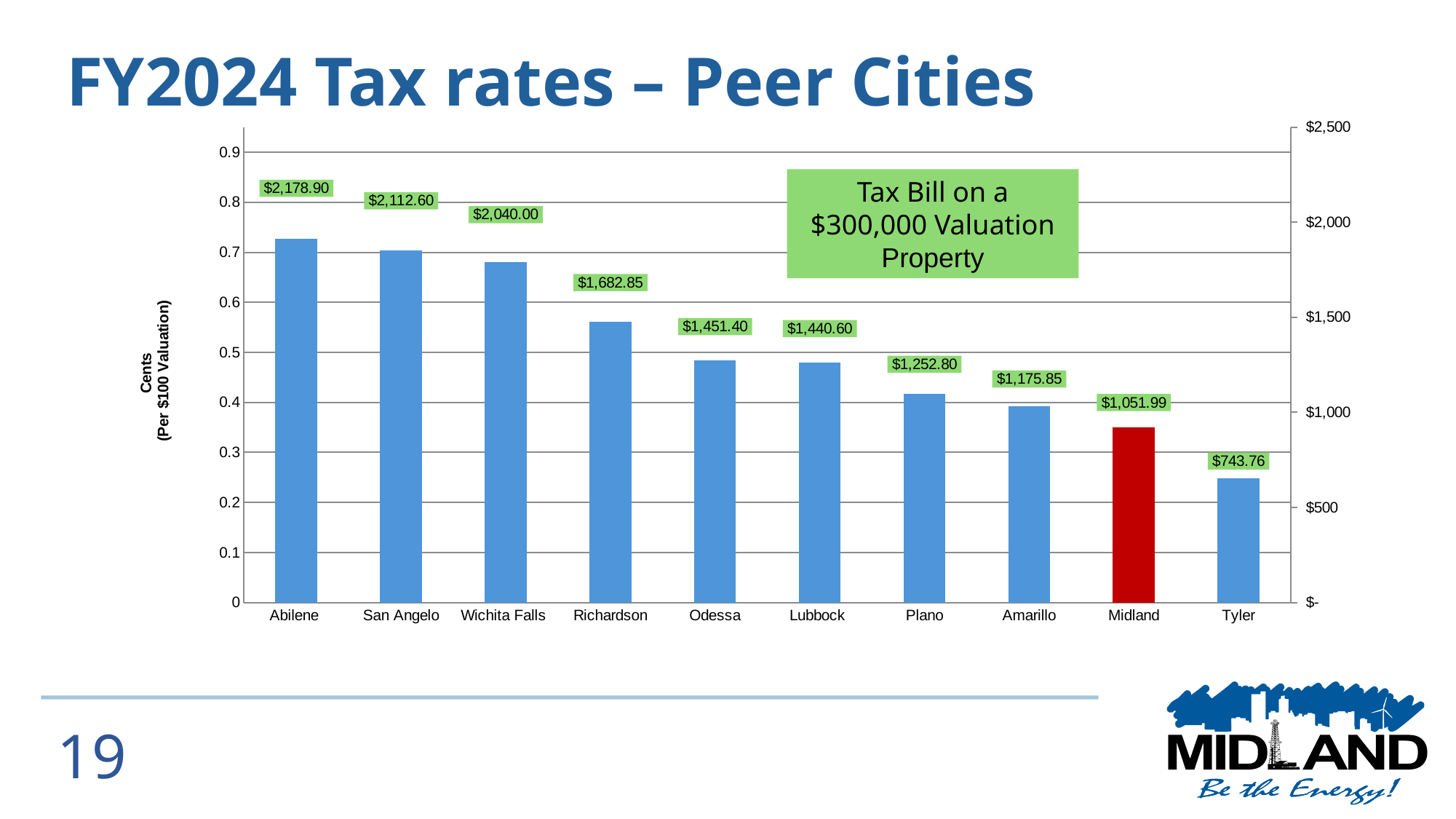
Which city has the lowest tax bill on a $300,000 valuation property? Tyler Which city has the highest tax bill on a $300,000 valuation property? Abilene What is the difference between the tax bills for Abilene and Tyler? $1,435.14 What is the tax bill on a $300,000 valuation property for Richardson? $1,682.85 What kind of chart is shown on the slide? Bar chart Is the tax rate bar for Abilene greater or less than 0.7 cents per $100 valuation? greater Do the tax rate bars rise or fall from left to right across the cities? Fall Is the tax rate bar for Tyler greater or less than 0.3 cents per $100 valuation? less How many cities are shown on the chart? 10 Which city has the larger tax bill, Plano or Amarillo? Plano Which city's bar is coloured red instead of blue? Midland What is the tax bill on a $300,000 valuation property for Midland? $1,051.99